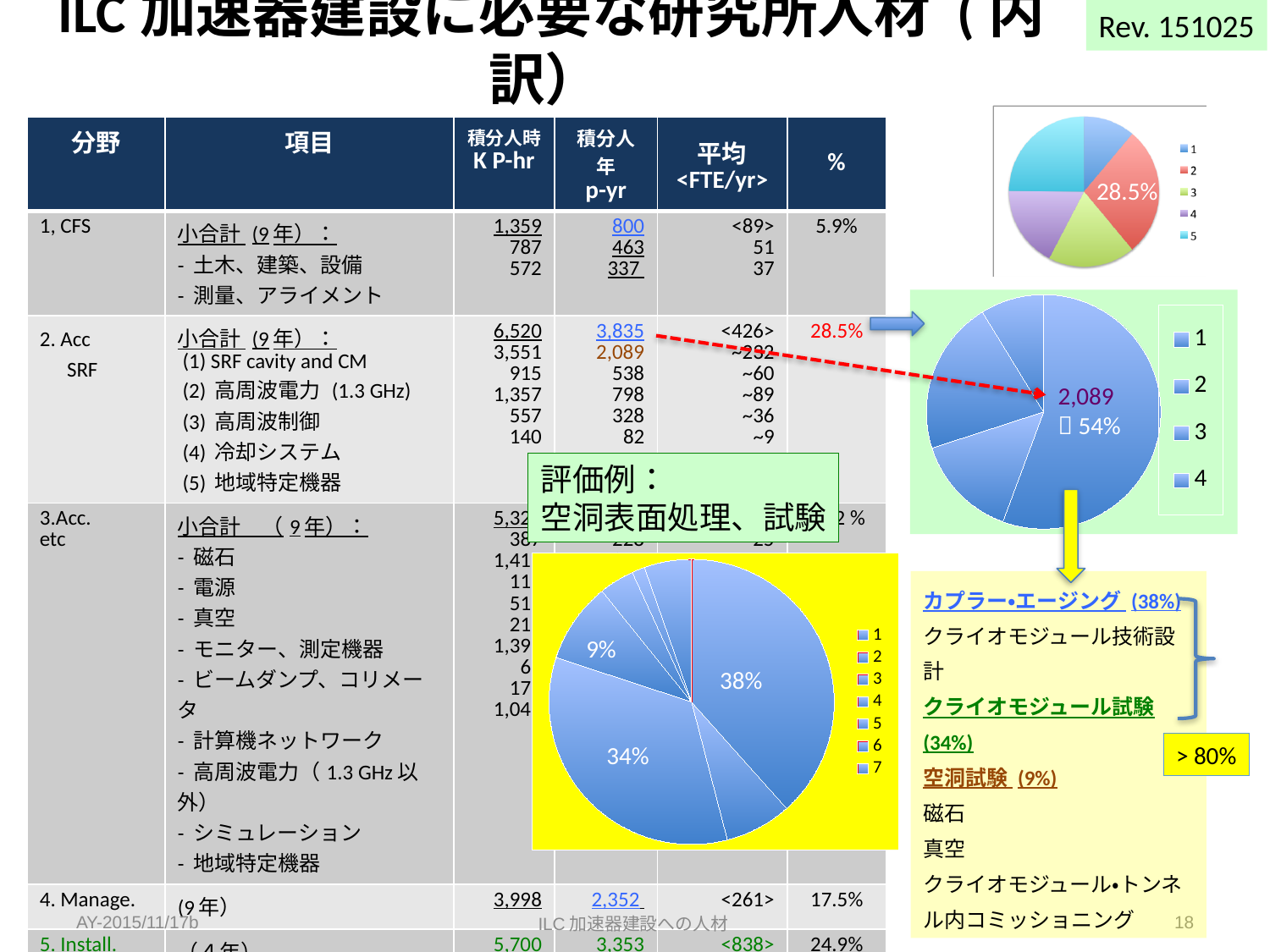
In the bottom pie chart (on the yellow background), what is the difference between the 38% slice and the 34% slice? 4 percentage points In the bottom pie chart (on the yellow background), which is larger: the slice labeled 34% or the slice labeled 9%? the slice labeled 34% How many entries does the legend of the middle-right pie chart (on the green background) list? 4 How many entries does the legend of the top-right pie chart list? 5 How many entries does the legend of the bottom pie chart (on the yellow background) list? 7 What type of chart is the chart in the top-right corner of the slide? pie chart What percentage is printed as a data label on the top-right pie chart? 28.5% What is the largest percentage printed on the bottom pie chart (on the yellow background)? 38% What type of chart is the chart on the yellow background at the bottom of the slide? pie chart What is the smallest percentage printed as a data label on the bottom pie chart (on the yellow background)? 9% In the middle-right pie chart (on the green background), which legend entry corresponds to the largest slice? 1 What numeric value is printed on the largest slice of the middle-right pie chart (on the green background)? 2,089